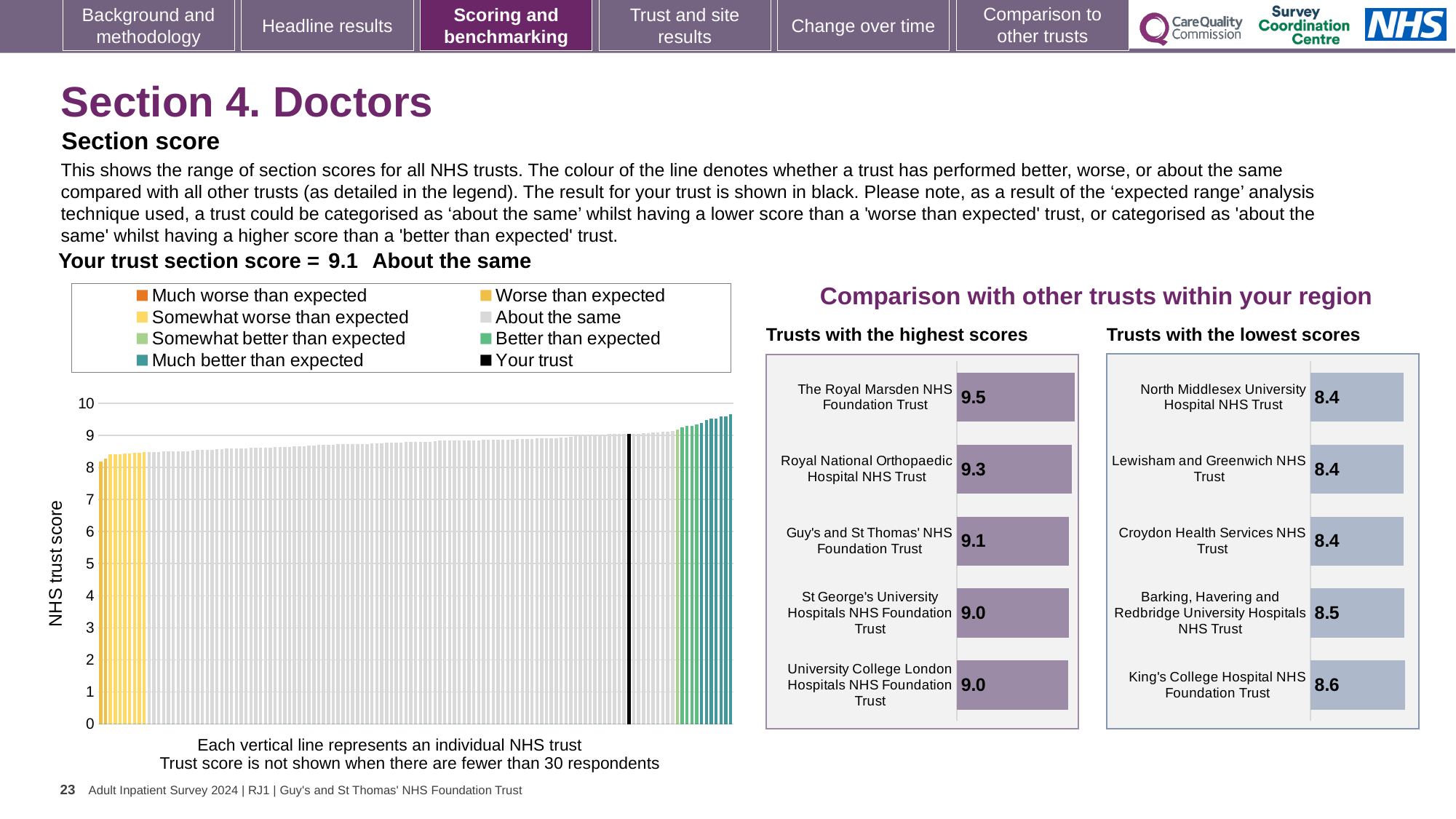
In the 'Trusts with the lowest scores' chart, which has the larger score: King's College Hospital NHS Foundation Trust or North Middlesex University Hospital NHS Trust? King's College Hospital NHS Foundation Trust In the 'Trusts with the highest scores' chart, what is the score for Royal National Orthopaedic Hospital NHS Trust? 9.3 In the 'Trusts with the lowest scores' chart, what is the difference between the scores of King's College Hospital NHS Foundation Trust and Barking, Havering and Redbridge University Hospitals NHS Trust? 0.1 In the 'Trusts with the highest scores' chart, how many trusts are shown? 5 In the 'Trusts with the highest scores' chart, what is the score for The Royal Marsden NHS Foundation Trust? 9.5 What kind of chart is the large chart on the left showing NHS trust scores? Bar chart In the 'Trusts with the lowest scores' chart, which trust has the highest score? King's College Hospital NHS Foundation Trust In the 'Trusts with the lowest scores' chart, what is the score for Barking, Havering and Redbridge University Hospitals NHS Trust? 8.5 In the 'Trusts with the highest scores' chart, which trust has the highest score? The Royal Marsden NHS Foundation Trust In the large chart on the left, how many entries does the legend list? 8 In the 'Trusts with the highest scores' chart, what is the difference between the scores of The Royal Marsden NHS Foundation Trust and Royal National Orthopaedic Hospital NHS Trust? 0.2 In the large chart on the left, is the value for the lowest-scoring trust greater or less than 8? greater